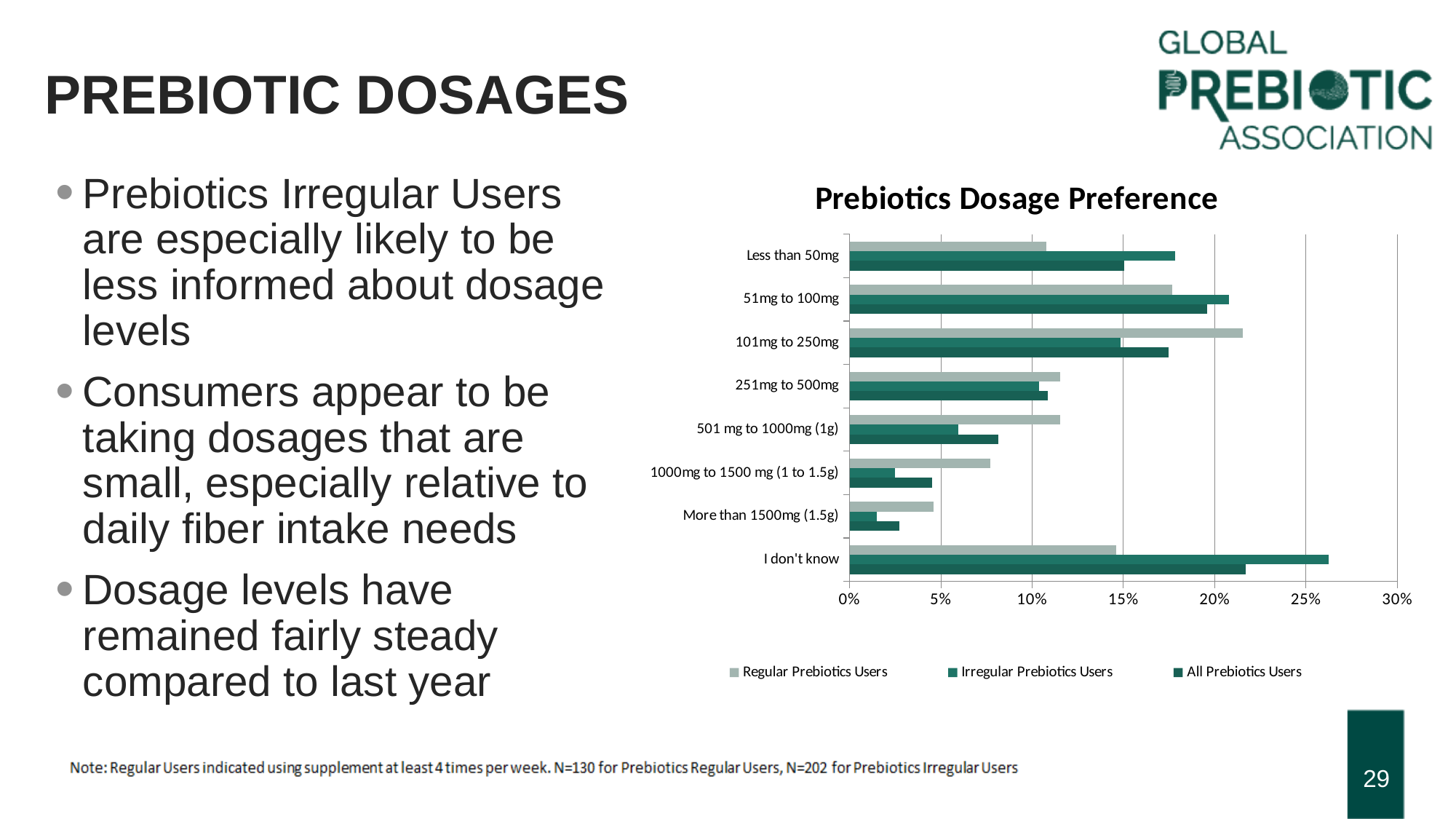
How many dosage categories are plotted in the Prebiotics Dosage Preference chart? 8 Is the value for Regular Prebiotics Users in the "101mg to 250mg" category greater or less than 20%? greater How many series does the legend of the Prebiotics Dosage Preference chart list? 3 Which dosage category has the highest value for Regular Prebiotics Users? 101mg to 250mg For the "501 mg to 1000mg (1g)" category, which is larger: Regular Prebiotics Users or Irregular Prebiotics Users? Regular Prebiotics Users Is the value for All Prebiotics Users in the "1000mg to 1500 mg (1 to 1.5g)" category greater or less than 5%? less What is the title of the chart on the slide? Prebiotics Dosage Preference Which dosage category has the lowest value for Irregular Prebiotics Users? More than 1500mg (1.5g) Which dosage category has the highest value for Irregular Prebiotics Users? I don't know Is the value for Irregular Prebiotics Users in the "I don't know" category greater or less than 25%? greater For the "Less than 50mg" category, which is larger: Regular Prebiotics Users or Irregular Prebiotics Users? Irregular Prebiotics Users What kind of chart is shown on the slide? bar chart